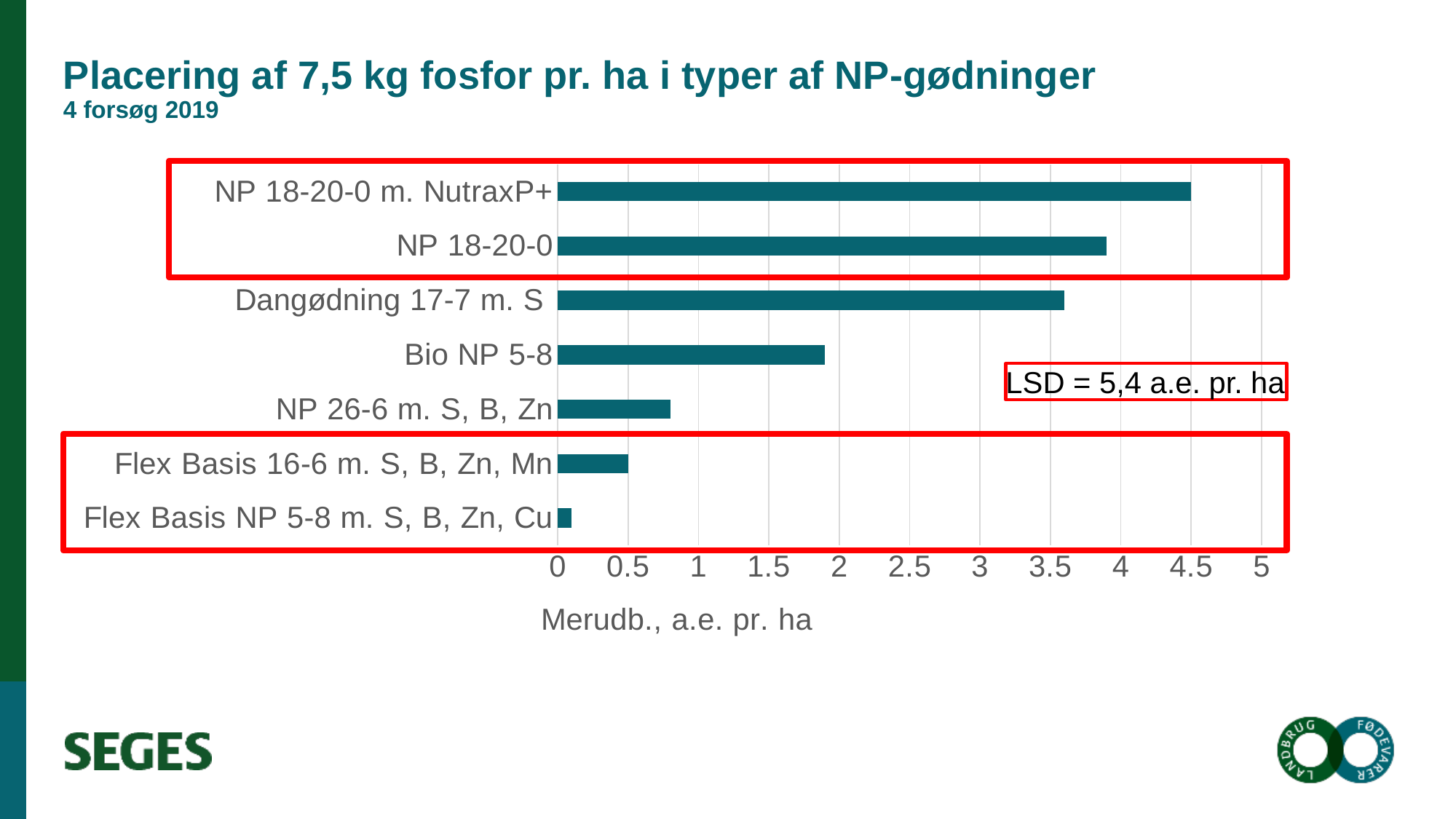
Which has the larger value: Bio NP 5-8 or NP 26-6 m. S, B, Zn? Bio NP 5-8 Is the value for Dangødning 17-7 m. S greater or less than 3? greater Which has the larger value: NP 18-20-0 or Dangødning 17-7 m. S? NP 18-20-0 Is the value for NP 26-6 m. S, B, Zn greater or less than 1? less Is the value for Bio NP 5-8 greater or less than 2? less How many fertiliser types (categories) are plotted in the chart? 7 What LSD value is stated in the box on the chart? LSD = 5,4 a.e. pr. ha What is the label of the horizontal axis of the chart? Merudb., a.e. pr. ha Which fertiliser type has the lowest Merudb., a.e. pr. ha? Flex Basis NP 5-8 m. S, B, Zn, Cu What kind of chart is shown on the slide? bar chart Which fertiliser type has the highest Merudb., a.e. pr. ha? NP 18-20-0 m. NutraxP+